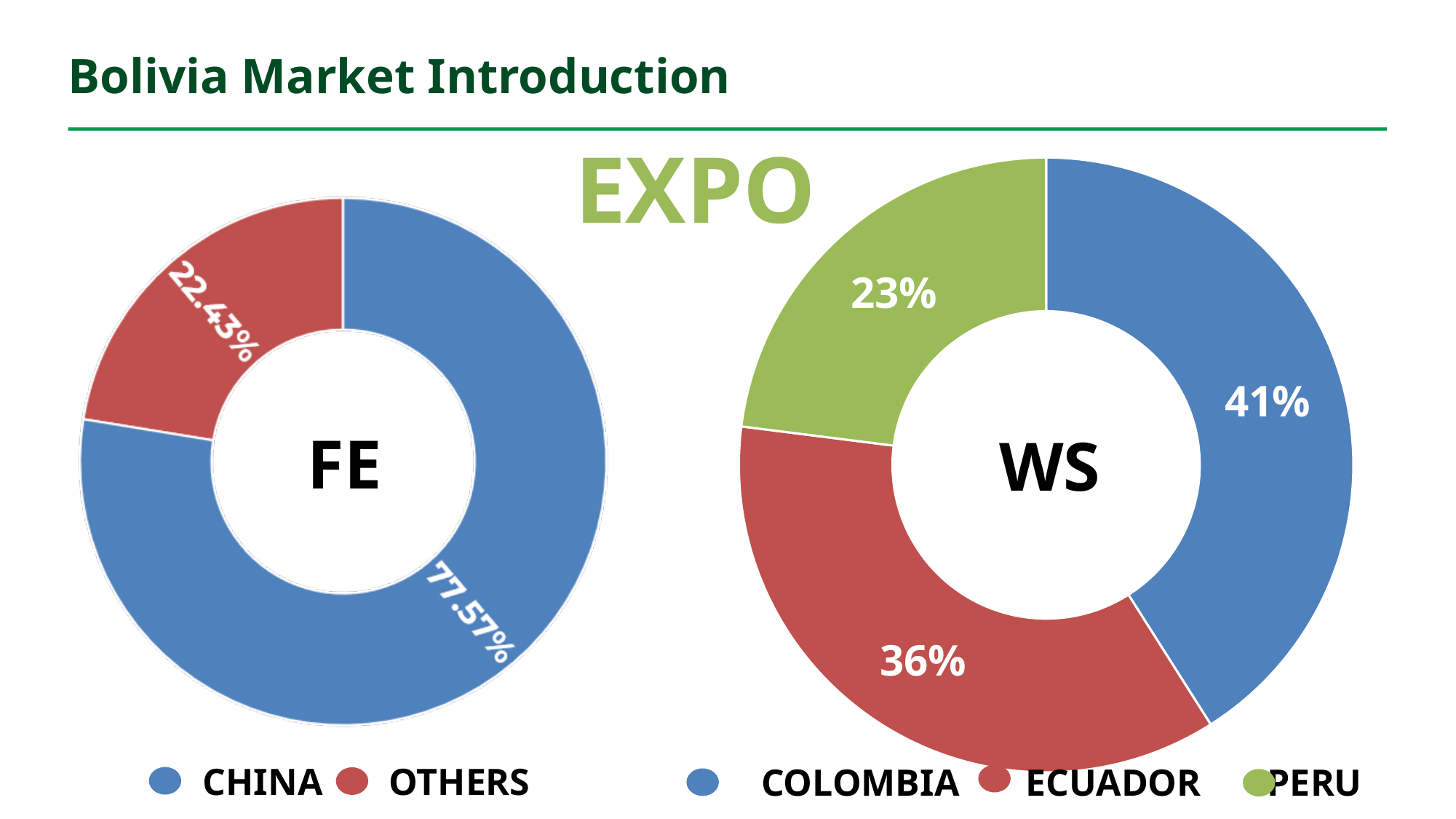
In the WS chart, which is larger, ECUADOR or PERU? ECUADOR How many categories does the WS chart's legend list? 3 In the WS chart, what share does PERU have? 23% In the FE chart, what share does CHINA have? 77.57% In the WS chart, which category has the largest share? COLOMBIA What kind of chart is the FE chart? Doughnut chart In the WS chart, which category has the smallest share? PERU In the WS chart, what share does COLOMBIA have? 41% In the FE chart, what share does OTHERS have? 22.43% In the FE chart, what is the difference between the CHINA and OTHERS shares? 55.14% In the WS chart, what is the difference between the COLOMBIA and PERU shares? 18% In the WS chart, what share does ECUADOR have? 36%